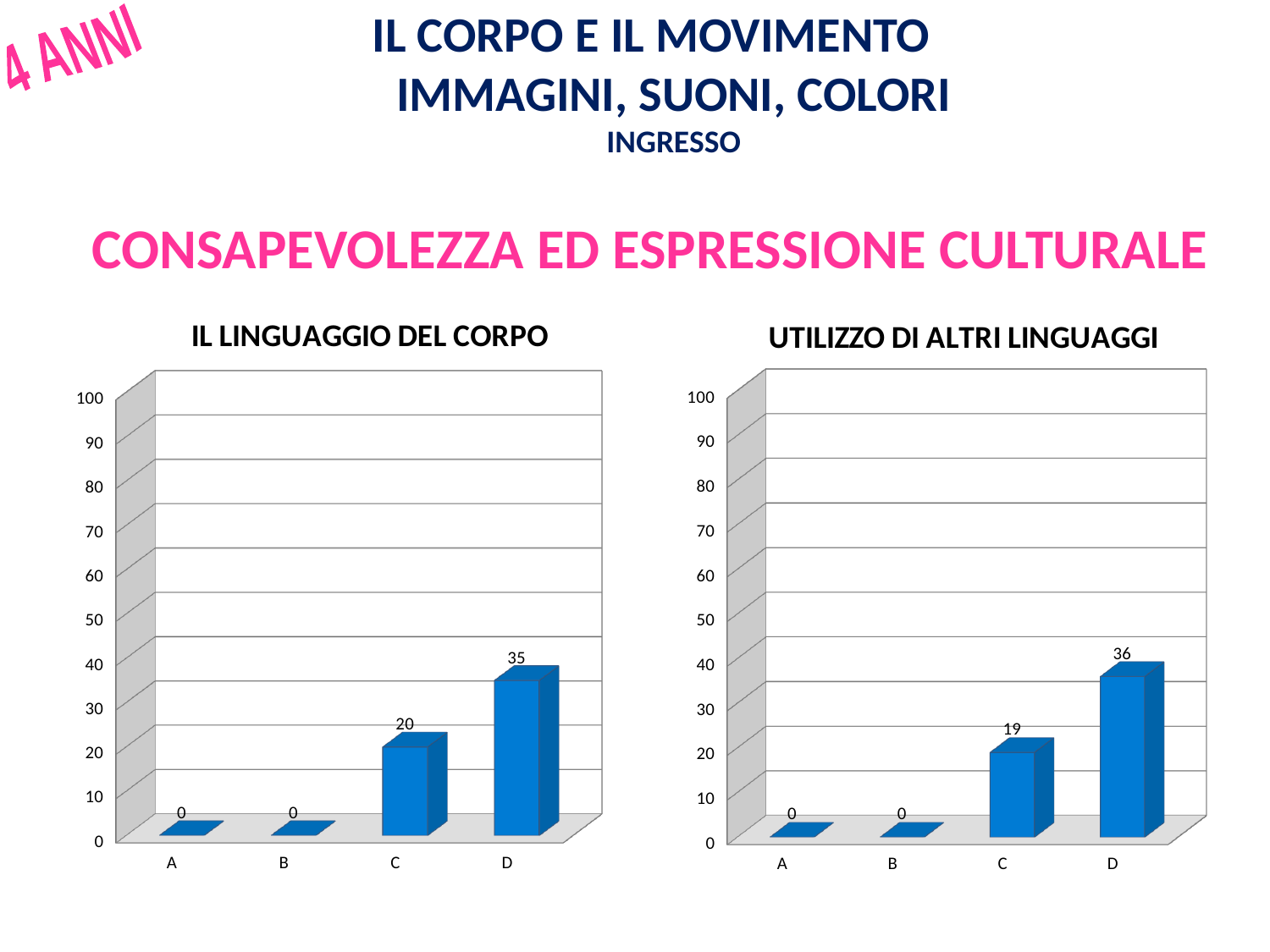
In the chart titled "UTILIZZO DI ALTRI LINGUAGGI", what is the difference between the values for D and C? 17 In the chart titled "IL LINGUAGGIO DEL CORPO", what is the value for category A? 0 In the chart titled "UTILIZZO DI ALTRI LINGUAGGI", what is the value for category C? 19 In the chart titled "IL LINGUAGGIO DEL CORPO", what is the value for category C? 20 In the chart titled "IL LINGUAGGIO DEL CORPO", how many categories are shown on the x axis? 4 In the chart titled "IL LINGUAGGIO DEL CORPO", what is the difference between the values for D and C? 15 In the chart titled "IL LINGUAGGIO DEL CORPO", which category has the highest value? D What kind of chart is the chart titled "UTILIZZO DI ALTRI LINGUAGGI"? Bar chart In the chart titled "IL LINGUAGGIO DEL CORPO", what is the value for category D? 35 In the chart titled "UTILIZZO DI ALTRI LINGUAGGI", what is the value for category D? 36 In the chart titled "UTILIZZO DI ALTRI LINGUAGGI", which is larger, the value for C or the value for D? D In the chart titled "UTILIZZO DI ALTRI LINGUAGGI", which category has the highest value? D